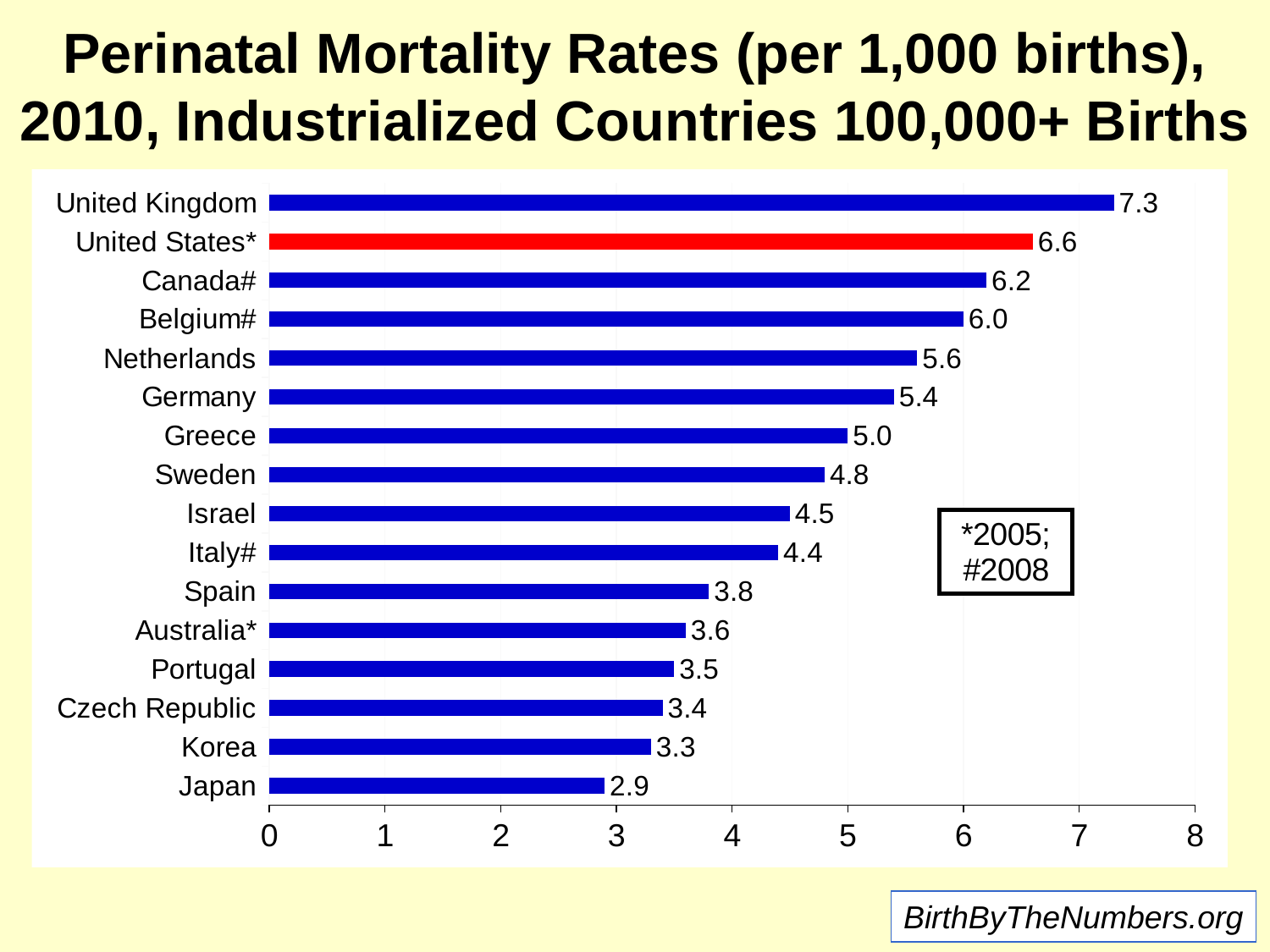
Which country's bar is coloured red? United States* What type of chart is shown on the slide? Bar chart What is the difference between the perinatal mortality rates of Canada# and Japan? 3.3 What is the perinatal mortality rate for the Netherlands? 5.6 Which country has the lowest perinatal mortality rate? Japan Which has a higher perinatal mortality rate, Germany or Greece? Germany What is the difference between the perinatal mortality rates of the United Kingdom and the United States*? 0.7 What is the perinatal mortality rate for the United States*? 6.6 Is the value for Sweden greater or less than 5? less How many countries are shown in the chart? 16 What is the perinatal mortality rate for Japan? 2.9 Which country has the highest perinatal mortality rate? United Kingdom